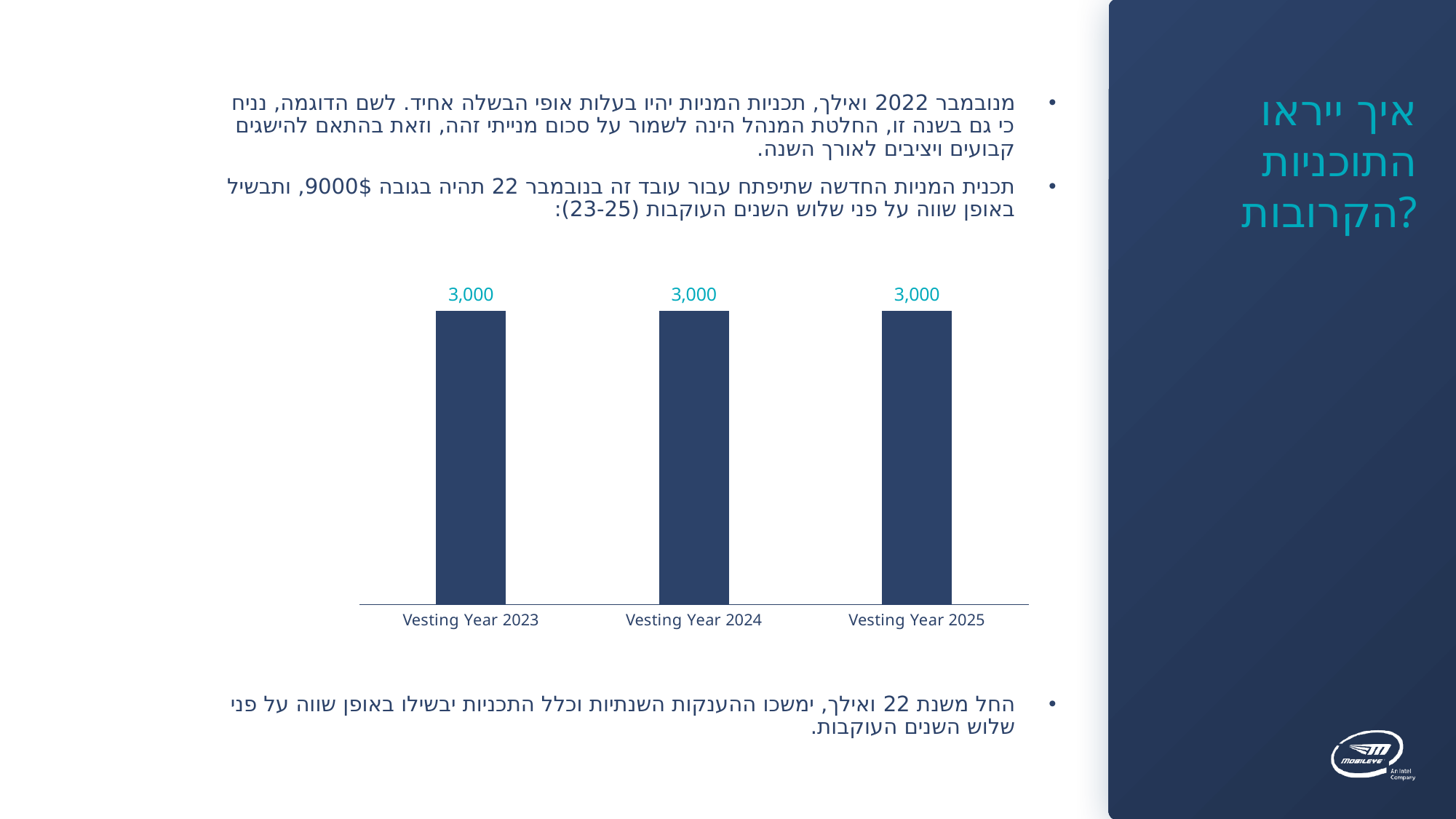
What is the value for Vesting Year 2024? 3,000 Do the values rise, fall or stay flat from Vesting Year 2023 to Vesting Year 2025? Stay flat How many categories are shown on the x axis of the chart? 3 What kind of chart is shown on the slide? Bar chart What is the difference between the values for Vesting Year 2023 and Vesting Year 2025? 0 What colour are the bars in the chart? Dark blue What is the total of the values for Vesting Year 2023, 2024 and 2025? 9,000 What is the label of the first category on the x axis? Vesting Year 2023 Is the value for Vesting Year 2024 larger than, smaller than, or equal to the value for Vesting Year 2023? Equal What is the value for Vesting Year 2023? 3,000 What is the value for Vesting Year 2025? 3,000